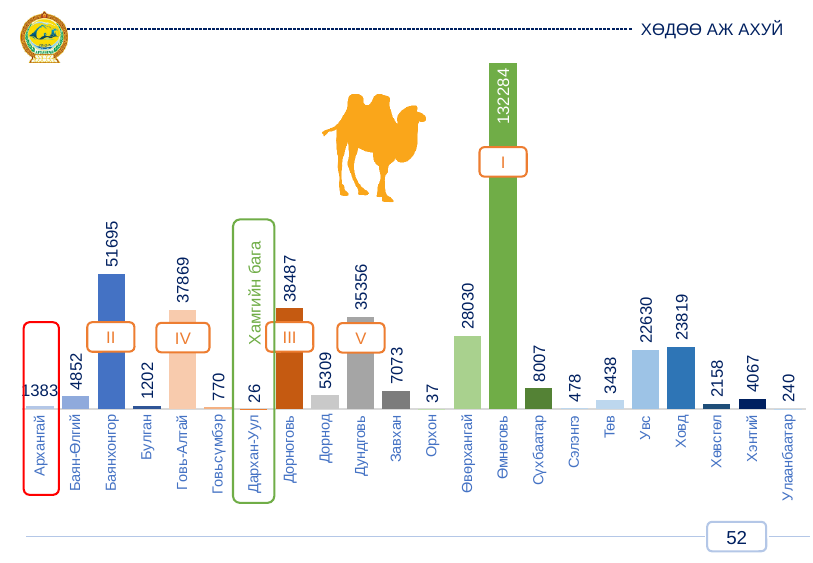
What is the value shown for Увс? 22630 Which category has the lowest value? Дархан-Уул What is the difference between the values for Ховд and Увс? 1189 What is the value shown for Өмнөговь? 132284 What is the value shown for Баянхонгор? 51695 What kind of chart is shown on the slide? Bar chart What is the value shown for Дархан-Уул? 26 What is the difference between the values for Өмнөговь and Баянхонгор? 80589 Which is larger, the value for Говь-Алтай or the value for Дорноговь? Дорноговь Which category is marked with the rank label "I"? Өмнөговь Which category has the highest value? Өмнөговь How many categories are shown on the chart? 22